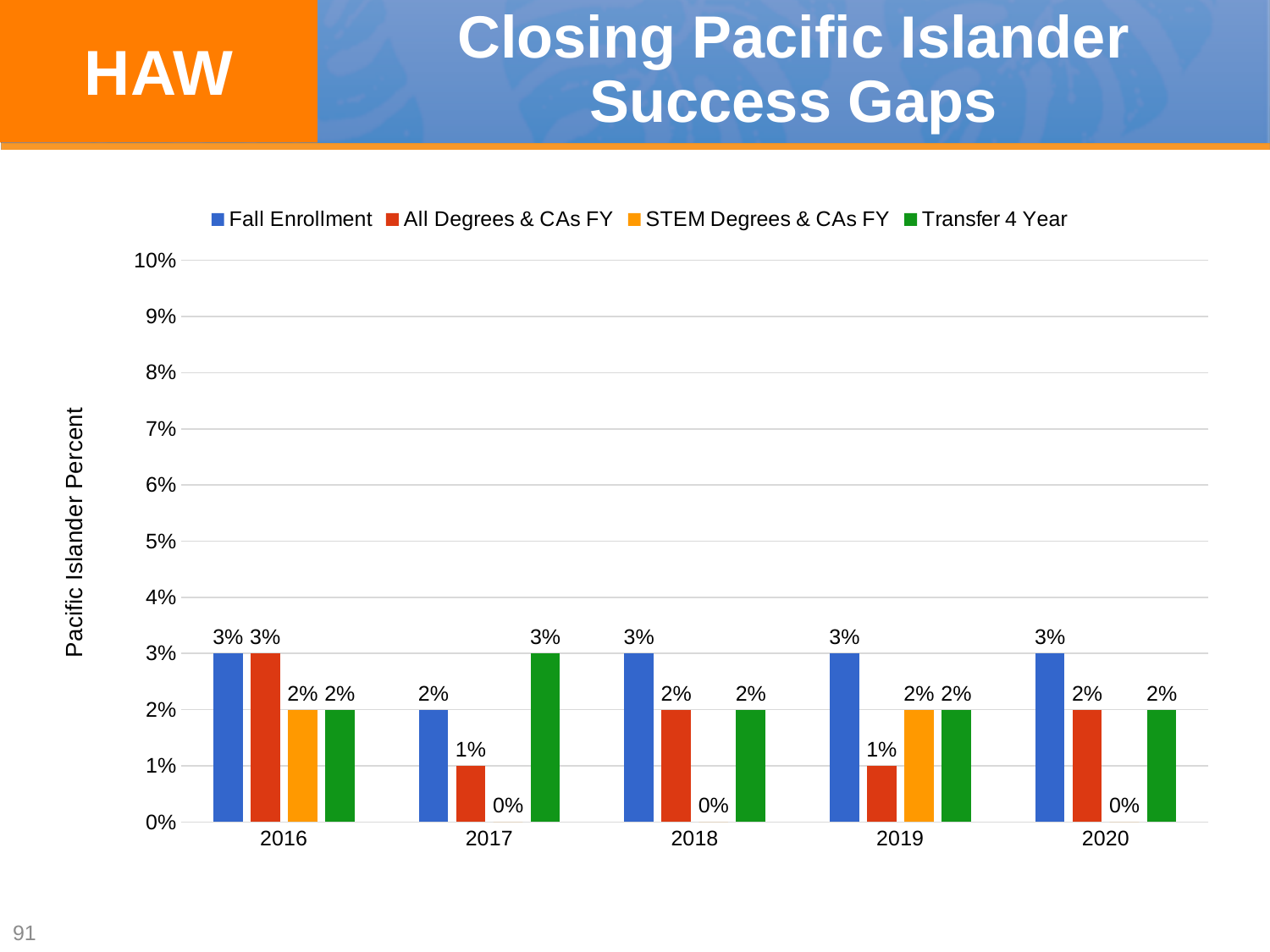
What is the STEM Degrees & CAs FY value for 2019? 2% What is the label of the vertical axis? Pacific Islander Percent What is the Fall Enrollment value for 2016? 3% Which is larger in 2017: Fall Enrollment or Transfer 4 Year? Transfer 4 Year What is the All Degrees & CAs FY value for 2018? 2% Which series has the lowest value in 2017? STEM Degrees & CAs FY What is the Transfer 4 Year value for 2017? 3% What is the difference between the Fall Enrollment value and the All Degrees & CAs FY value in 2019? 2% What kind of chart is shown on the slide? Bar chart How many series does the legend list? 4 How many years are shown on the x axis? 5 In which year is the Transfer 4 Year value highest? 2017